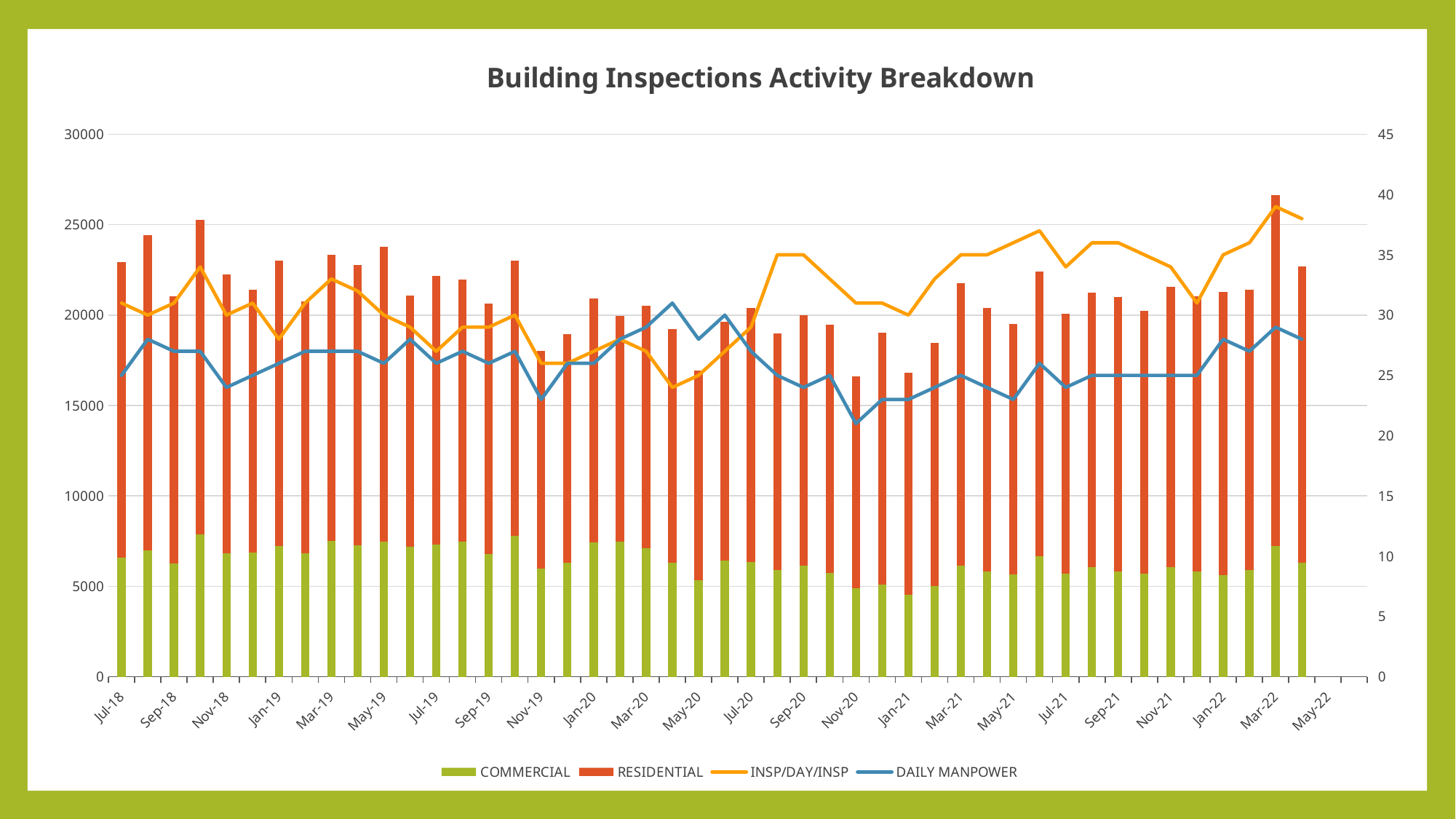
Which series is drawn in green? COMMERCIAL What kind of chart is shown on the slide? Combination stacked bar and line chart In which month is the total stacked bar (Commercial plus Residential) the highest? Mar-22 Is the total stacked bar for Mar-22 greater or less than 25000? greater In which month does the DAILY MANPOWER line reach its lowest value? Nov-20 Is the DAILY MANPOWER value for Nov-20 greater or less than 25 on the right axis? less What is the title of the chart? Building Inspections Activity Breakdown Is the total stacked bar for Nov-20 greater or less than 20000? less Which has the larger total stacked bar, Jul-18 or Mar-22? Mar-22 Does the INSP/DAY/INSP line rise or fall from Jul-20 to Sep-20? rise In which month does the INSP/DAY/INSP line reach its highest value? Mar-22 How many series does the legend list? 4